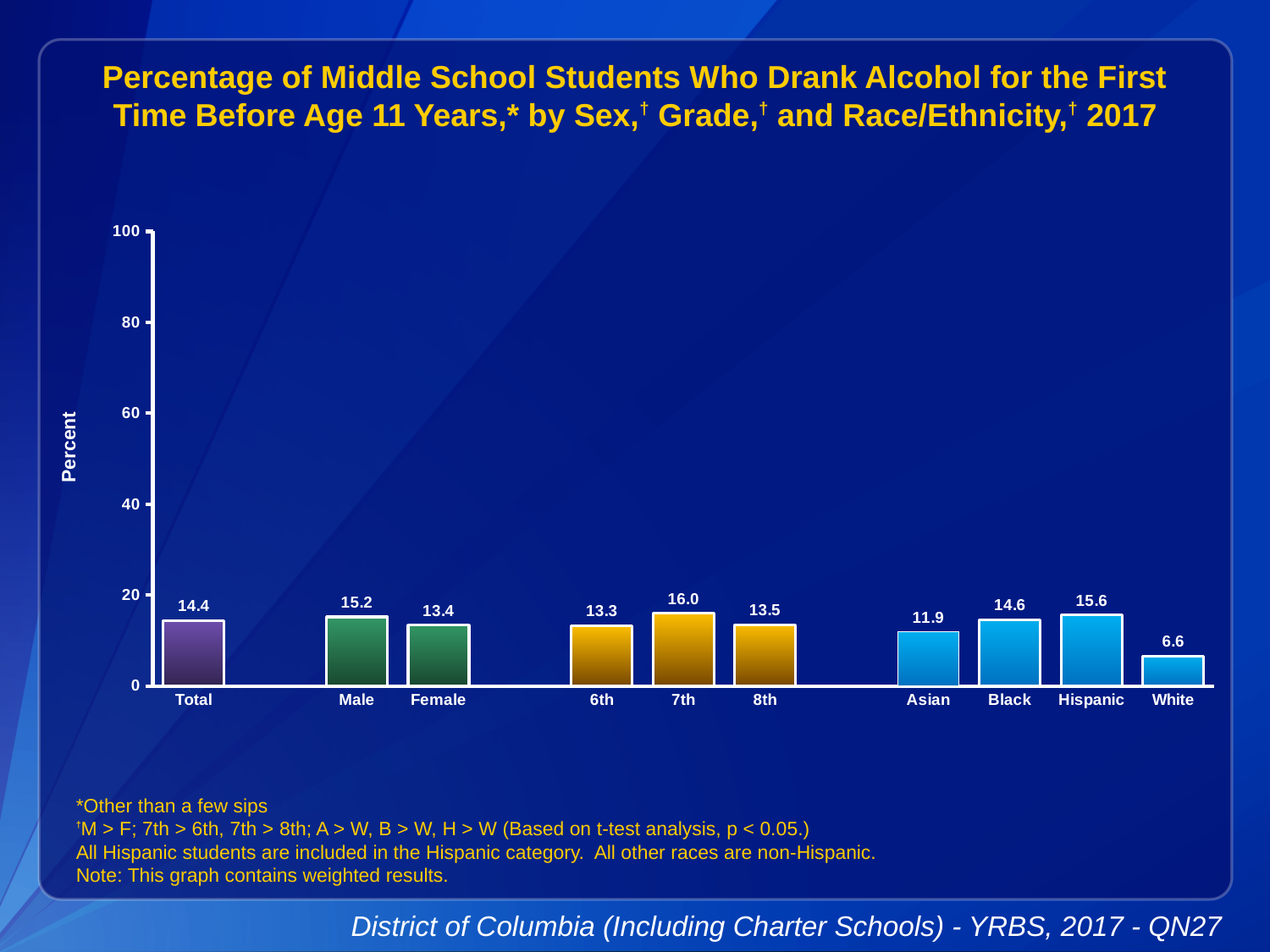
What is the value for Male? 15.2 Which category has the lowest value? White What is the difference between the values for Hispanic and White? 9.0 Which is larger, the value for Black or the value for Asian? Black What is the value for Total? 14.4 What is the label of the y axis? Percent What kind of chart is this? bar chart What is the difference between the values for Male and Female? 1.8 Is the value for 7th greater or less than 20? less How many categories are shown on the x axis? 10 Which category has the highest value? 7th What is the value for White? 6.6